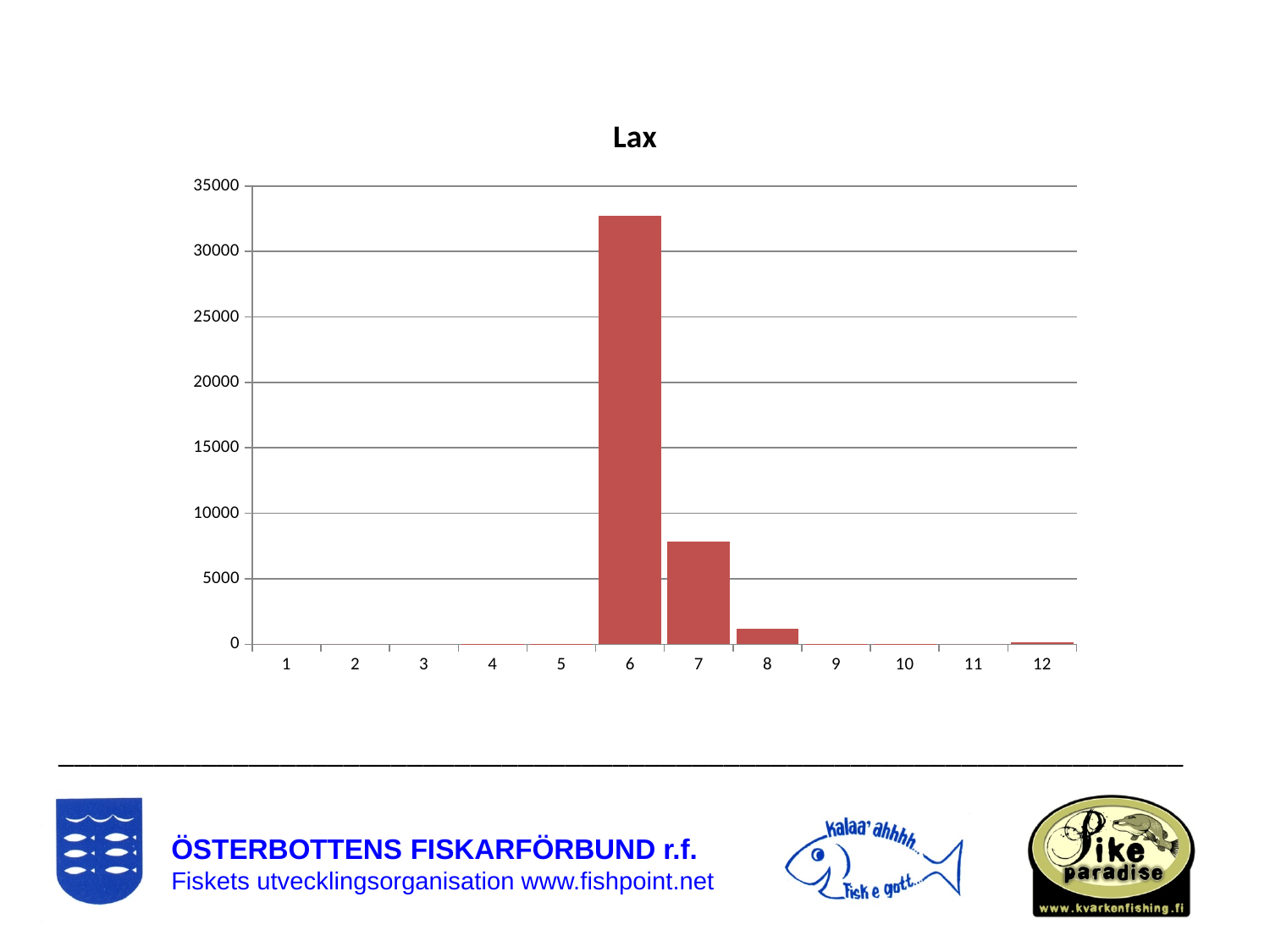
What is the title of the chart? Lax Do the values rise or fall from category 6 to category 8? fall Which is larger, the value for category 7 or the value for category 8? 7 Is the value for category 6 greater or less than 30000? greater Is the value for category 6 greater or less than 35000? less Is the value for category 8 greater or less than 5000? less What kind of chart is shown on the slide? bar chart Which is larger, the value for category 6 or the value for category 7? 6 Which category has the highest value in the chart? 6 How many categories are shown on the x axis of the chart? 12